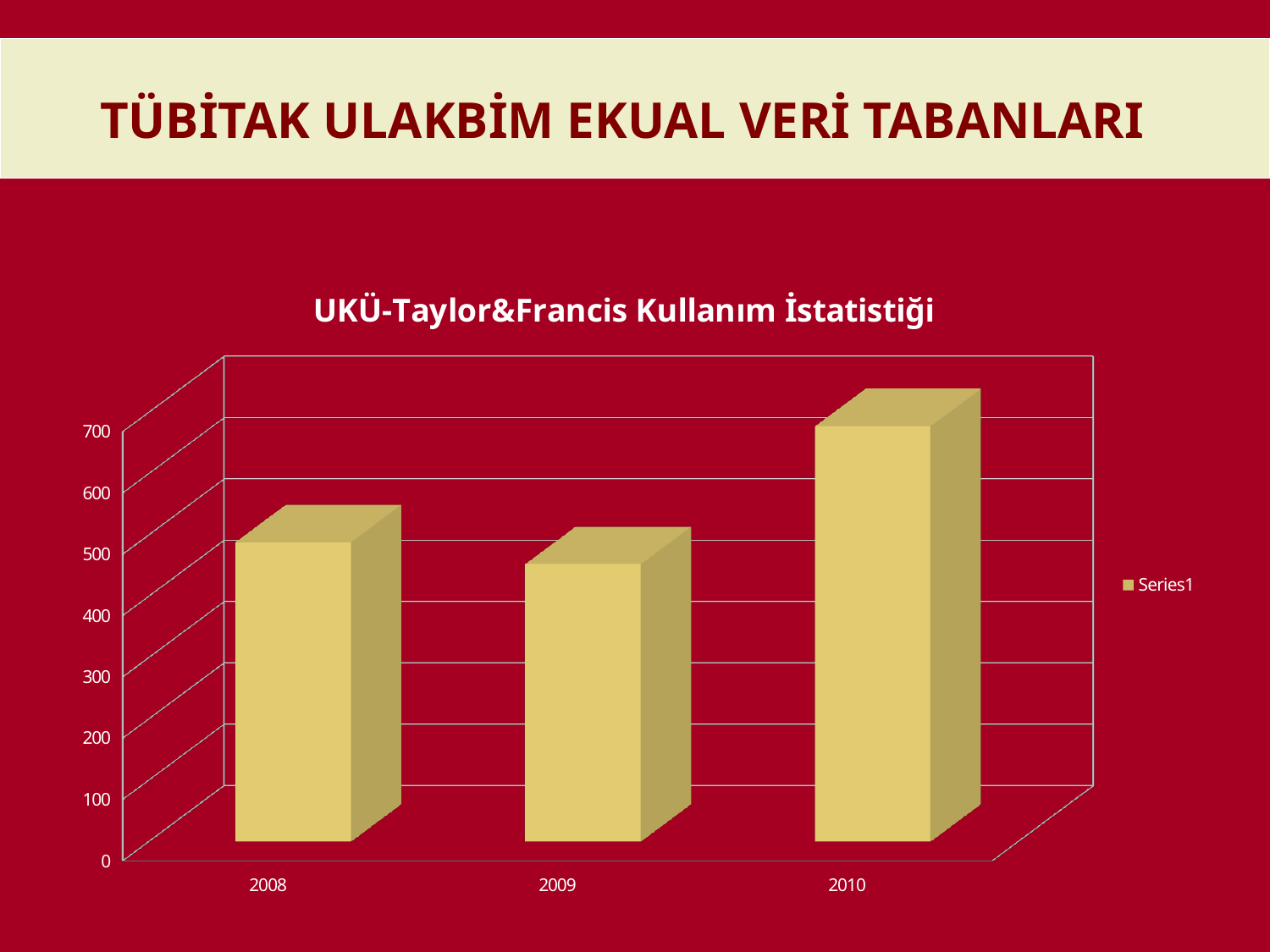
Which year has the highest value in the chart? 2010 Is the value for 2010 greater or less than 600? greater Which is larger, the value for 2008 or the value for 2009? 2008 Which year has the lowest value in the chart? 2009 Is the value for 2008 greater or less than 600? less How many categories (years) are shown on the x axis of the chart? 3 Is the value for 2009 greater or less than 400? greater What kind of chart is shown on the slide? bar chart How many series does the chart's legend list? 1 What is the name of the series shown in the legend? Series1 What is the title of the chart? UKÜ-Taylor&Francis Kullanım İstatistiği Does the value rise or fall from 2009 to 2010? rise